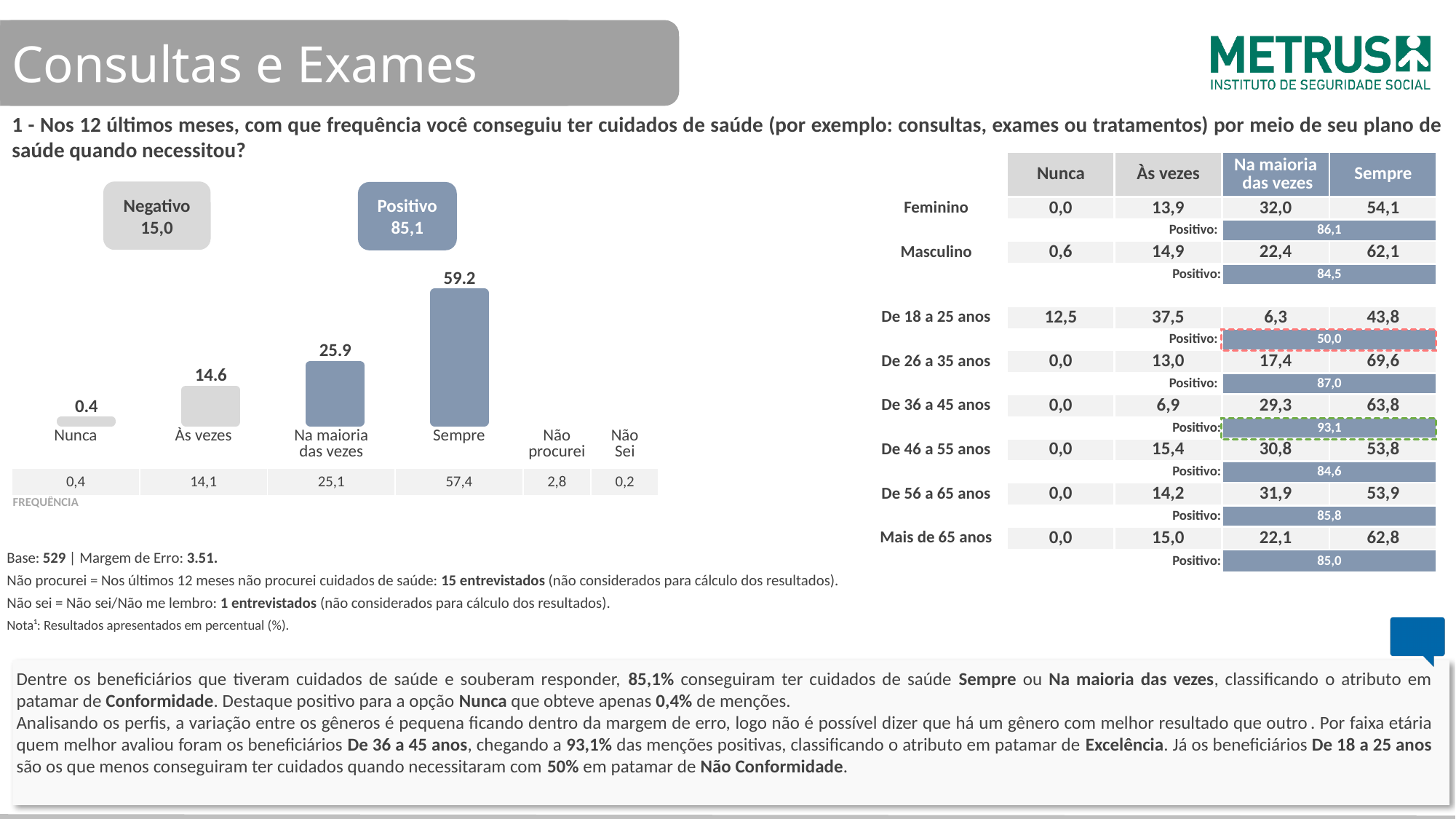
What is the difference between the values for 'Sempre' and 'Na maioria das vezes'? 33.3 What value is shown in the 'Positivo' box above the bar chart? 85,1 What is the difference between the values for 'Às vezes' and 'Nunca'? 14.2 What is the value for 'Às vezes' in the bar chart? 14.6 What is the value for 'Sempre' in the bar chart? 59.2 What type of chart is shown on the slide? bar chart Which category has the highest value in the bar chart? Sempre Which category has the lowest value among the plotted bars? Nunca What is the value for 'Nunca' in the bar chart? 0.4 Do the bar values rise or fall from 'Nunca' to 'Sempre' along the x axis? rise Which is larger, the value for 'Às vezes' or the value for 'Na maioria das vezes'? Na maioria das vezes What is the value for 'Na maioria das vezes' in the bar chart? 25.9